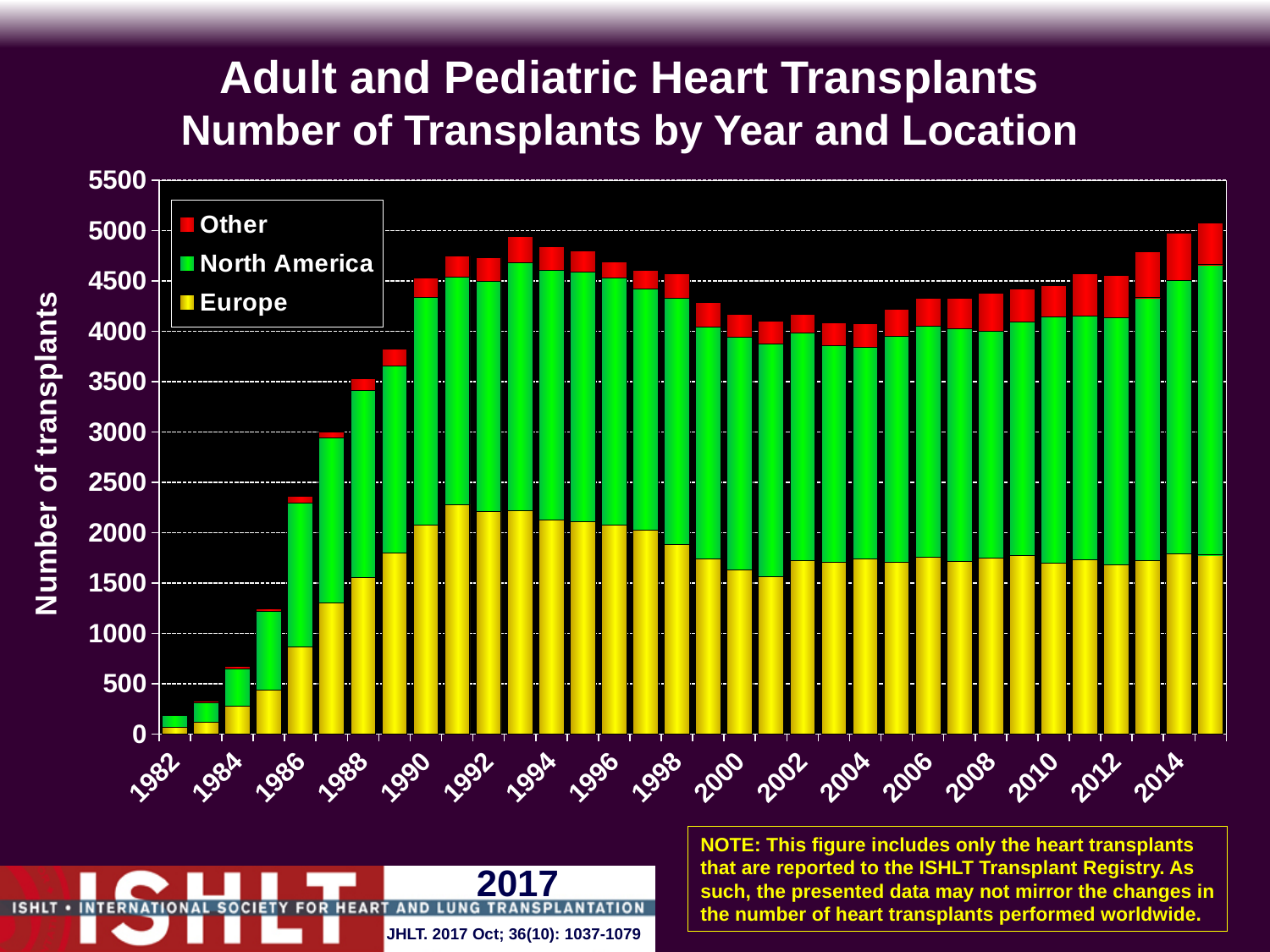
How many series does the legend list? 3 Do the total number of transplants rise or fall from 1982 to 1993? rise Is the total number of transplants in 1990 greater or less than 4000? greater Is the total number of transplants in 1982 greater or less than 500? less Which series is shown in yellow in the legend? Europe Which year has the larger total number of transplants, 1990 or 2000? 1990 Which year has the lowest total number of transplants? 1982 What is the label of the vertical axis? Number of transplants How many year labels are printed along the x axis? 17 Is the total number of transplants in 1988 greater or less than 3000? greater What kind of chart is shown on the slide? Stacked bar chart